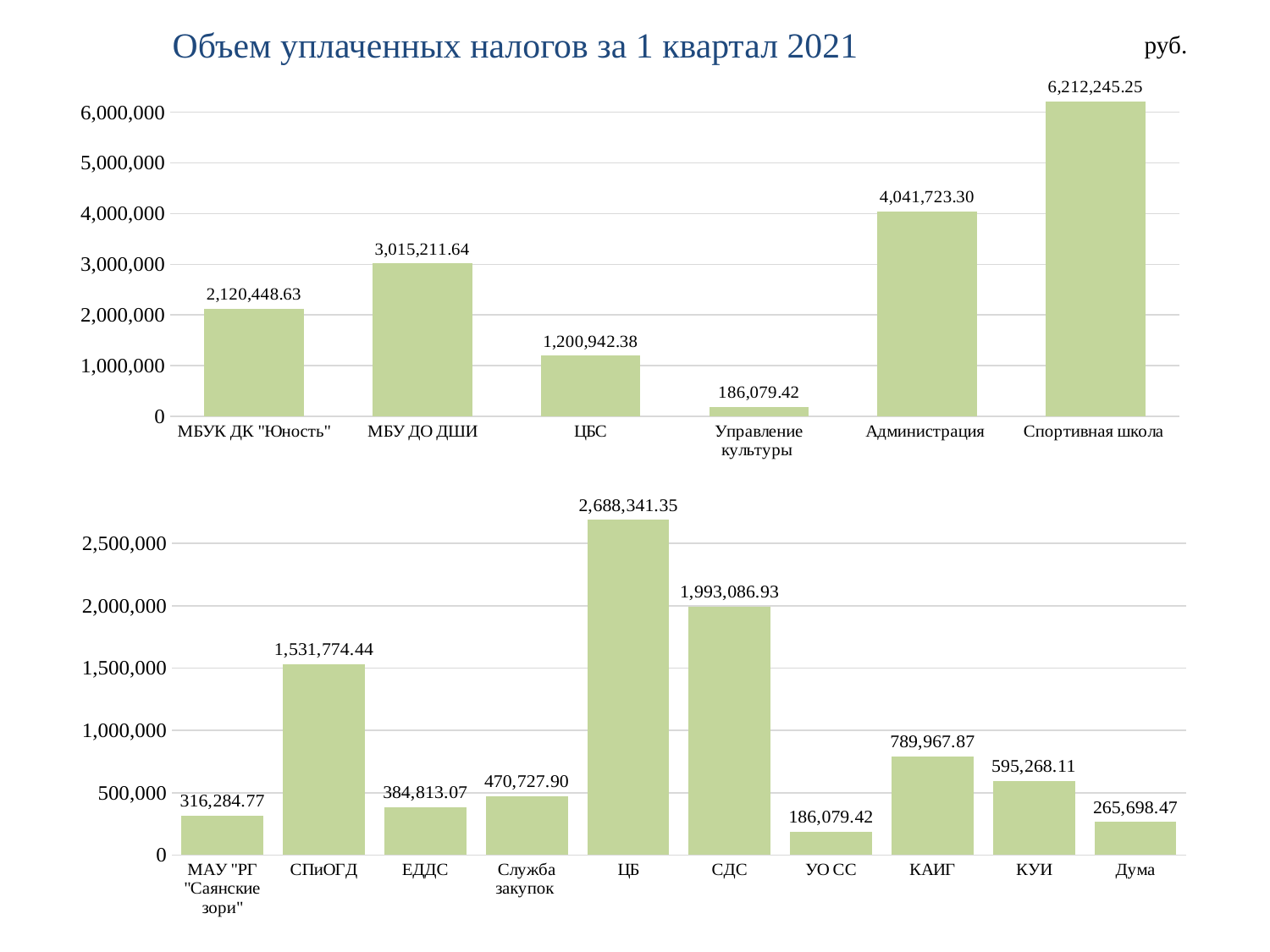
In the top chart, which category has the lowest value? Управление культуры In the bottom chart, what is the value for СПиОГД? 1,531,774.44 In the top chart, what is the value for Администрация? 4,041,723.30 In the top chart, what is the difference between Спортивная школа and Администрация? 2,170,521.95 In the bottom chart, which is larger, КАИГ or КУИ? КАИГ In the bottom chart, how many categories are shown? 10 In the bottom chart, which category has the highest value? ЦБ In the top chart, which category has the highest value? Спортивная школа In the top chart, how many categories are shown? 6 In the bottom chart, what is the difference between ЦБ and СДС? 695,254.42 In the bottom chart, which category has the lowest value? УО СС What type of chart is the bottom chart? Bar chart